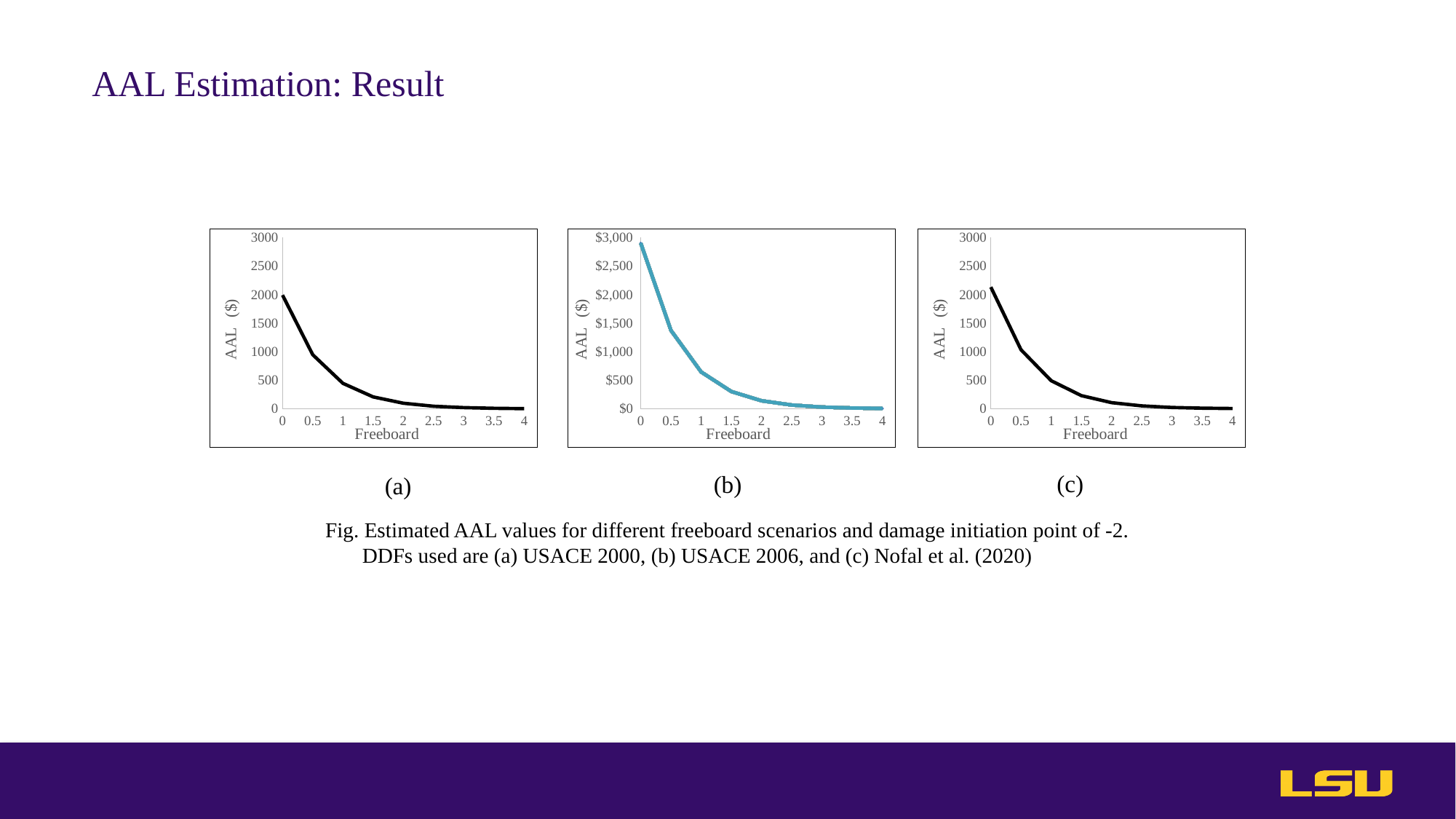
In chart (b), is the AAL value at Freeboard 1 greater or less than $500? greater What is the x-axis label of chart (c)? Freeboard What kind of chart is chart (a)? line chart In chart (b), is the AAL value at Freeboard 0 greater or less than $2,500? greater In chart (c), is the AAL value at Freeboard 1.5 greater or less than 500? less In chart (a), at which Freeboard value is the AAL highest? 0 Which is larger: the AAL at Freeboard 0 in chart (b) or the AAL at Freeboard 0 in chart (a)? chart (b) What colour is the line in chart (b)? blue In chart (c), at which Freeboard value is the AAL lowest? 4 In chart (b), do the AAL values rise or fall as Freeboard increases from 0 to 4? fall